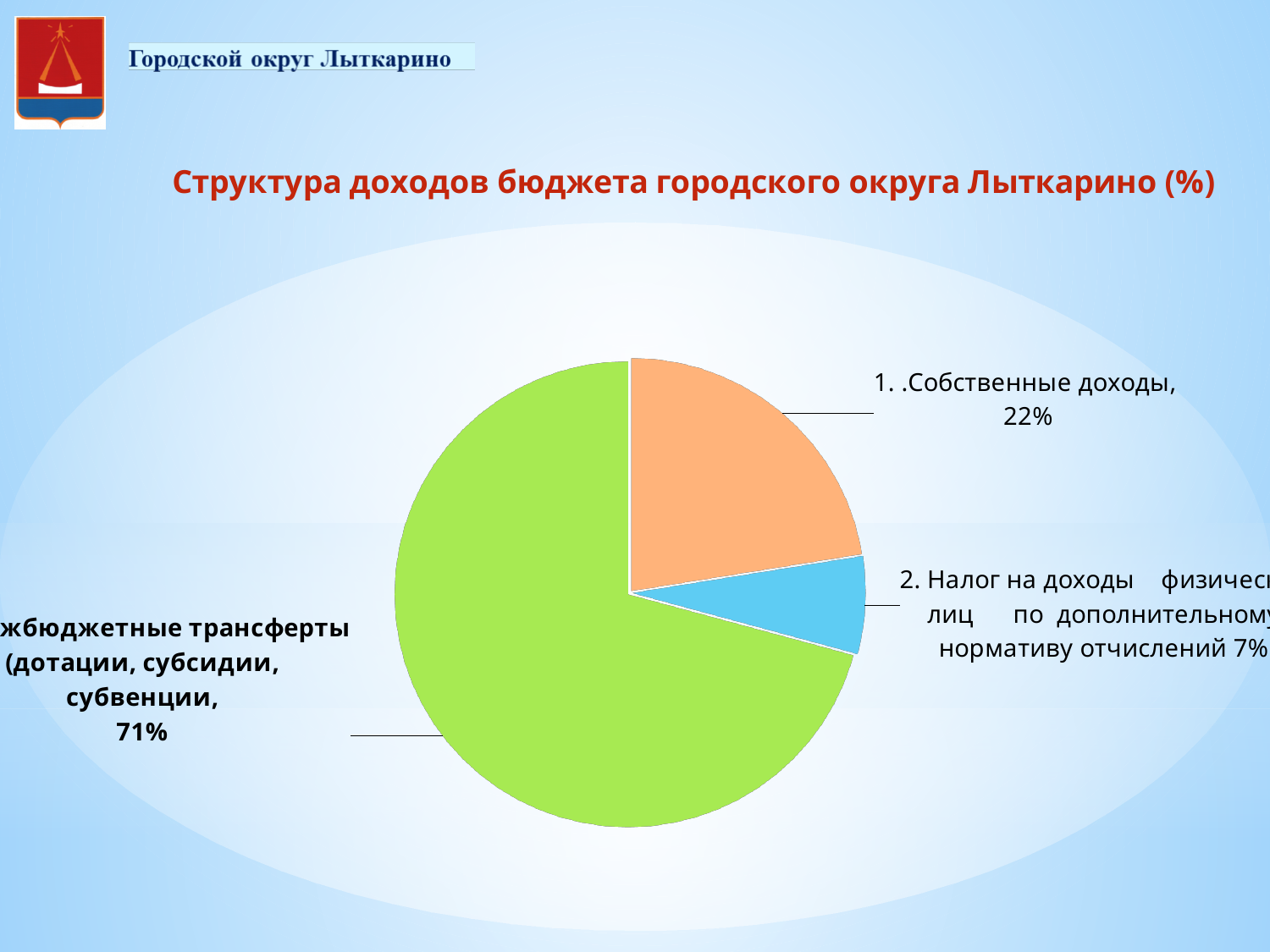
How many slices does the pie chart have? 3 What is the difference in percentage points between "Межбюджетные трансферты" and "Собственные доходы"? 49 What colour is the slice for "Межбюджетные трансферты"? green What percentage is shown for "Налог на доходы физических лиц по дополнительному нормативу отчислений"? 7% What is the combined share of "Собственные доходы" and "Налог на доходы физических лиц"? 29% Which category has the largest share of the pie? Межбюджетные трансферты (дотации, субсидии, субвенции) What share of the pie is labelled "Собственные доходы"? 22% Which is larger: the share for "Собственные доходы" or the share for "Налог на доходы физических лиц"? Собственные доходы What is the title of the chart? Структура доходов бюджета городского округа Лыткарино (%) Which category has the smallest share of the pie? Налог на доходы физических лиц по дополнительному нормативу отчислений What type of chart is shown on the slide? pie chart What percentage is shown for "Межбюджетные трансферты (дотации, субсидии, субвенции)"? 71%